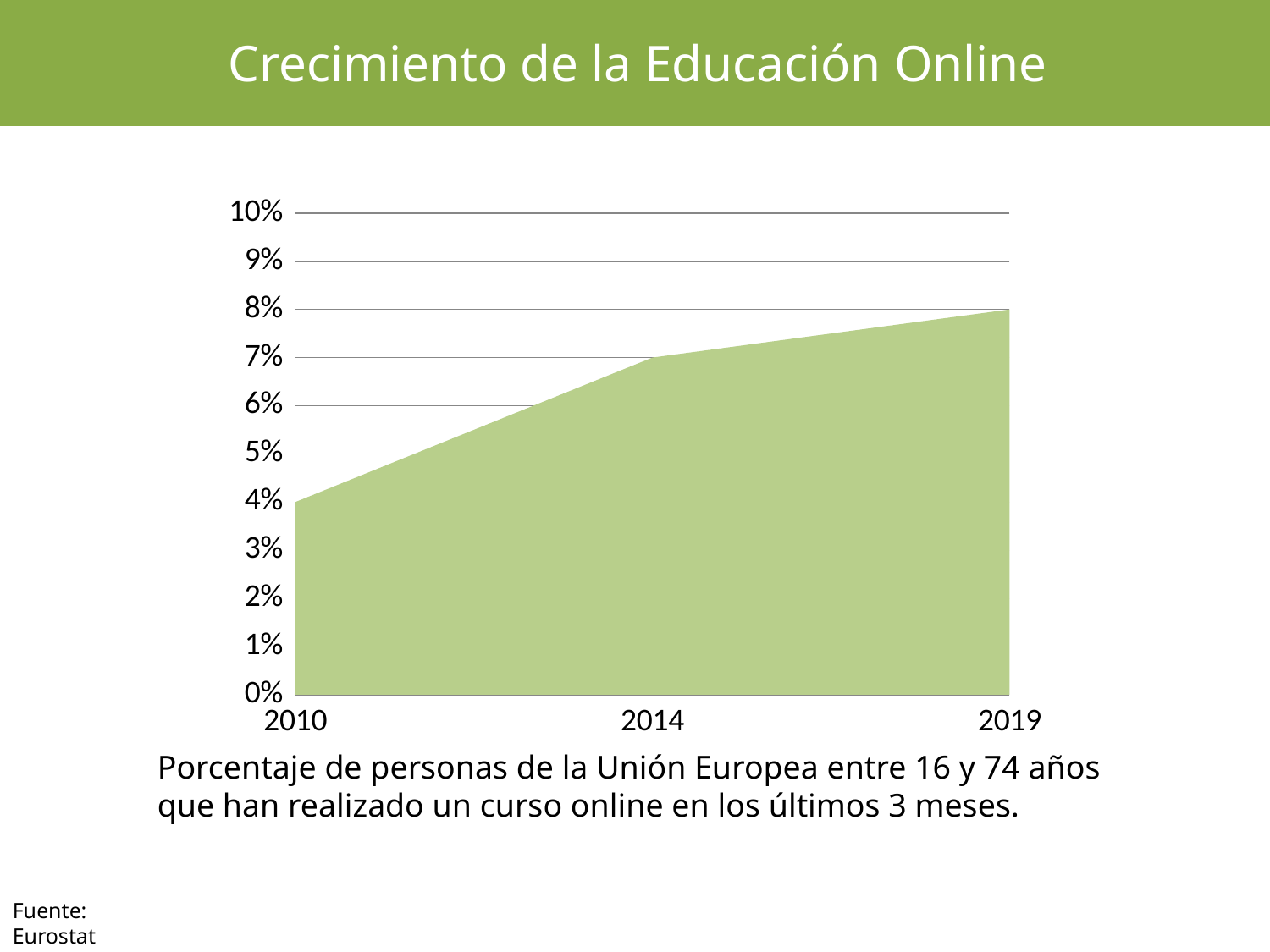
Which year has the lowest value? 2010 What is the title of the chart? Crecimiento de la Educación Online Which is larger, the value for 2014 or the value for 2010? 2014 What is the value for 2019? 8% What is the value for 2014? 7% How many years are labelled on the x axis? 3 What is the difference between the values for 2014 and 2010? 3% Which year has the highest value? 2019 What is the difference between the values for 2019 and 2010? 4% What kind of chart is shown on the slide? Area chart What is the value for 2010? 4% Do the values rise or fall from 2010 to 2019? Rise